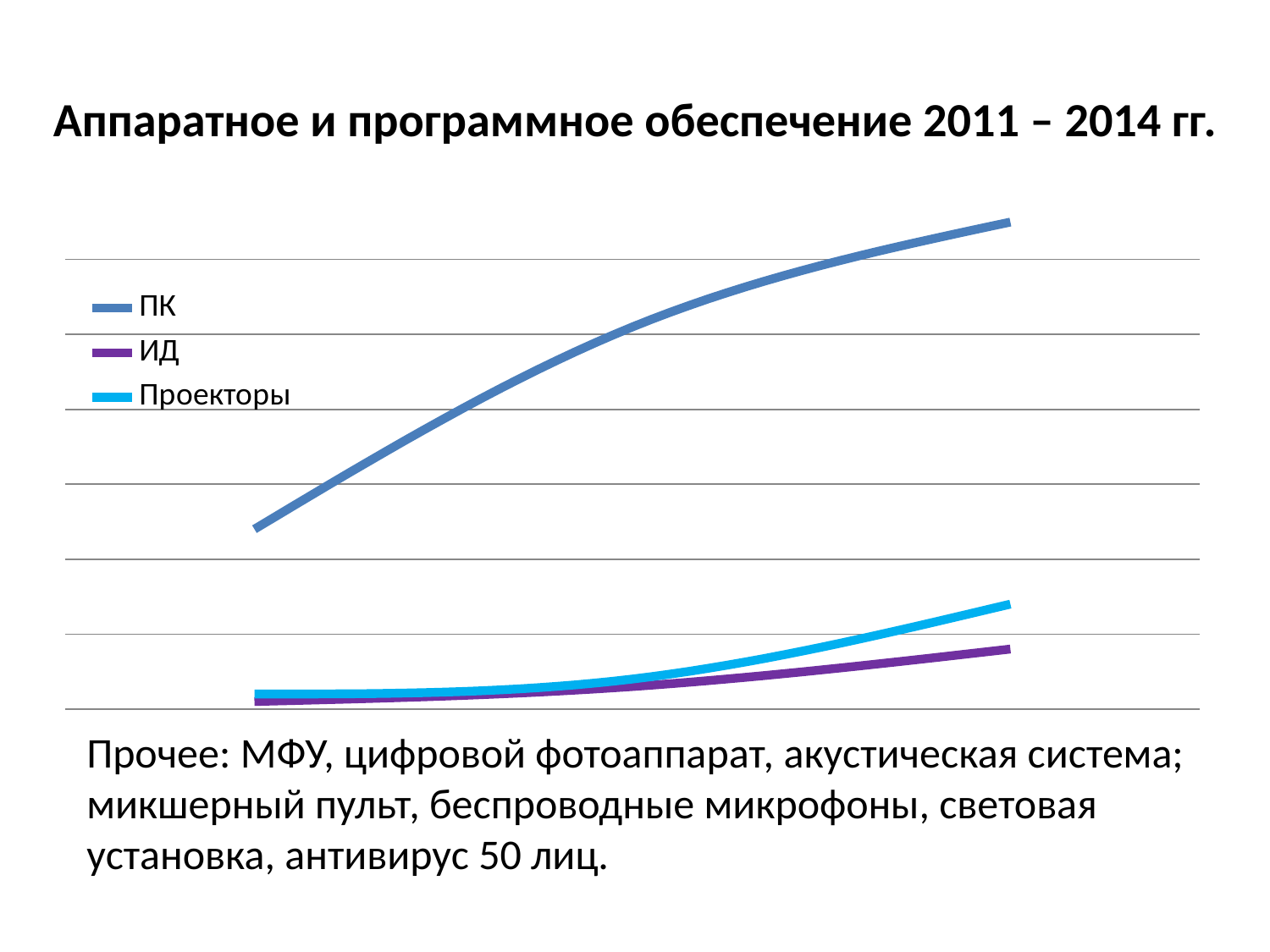
Does the ИД line rise or fall from left to right? rises What kind of chart is shown on the slide? line chart What are the series names listed in the legend? ПК, ИД, Проекторы What is the title of the chart? Аппаратное и программное обеспечение 2011 – 2014 гг. Which series has the lowest value at the right end of the chart? ИД Does the ПК line rise or fall from left to right? rises How many series does the legend list? 3 At the right end of the chart, which is higher: ПК or Проекторы? ПК Does the Проекторы line rise or fall from left to right? rises Which series has the highest values across the chart? ПК At the right end of the chart, which is higher: Проекторы or ИД? Проекторы